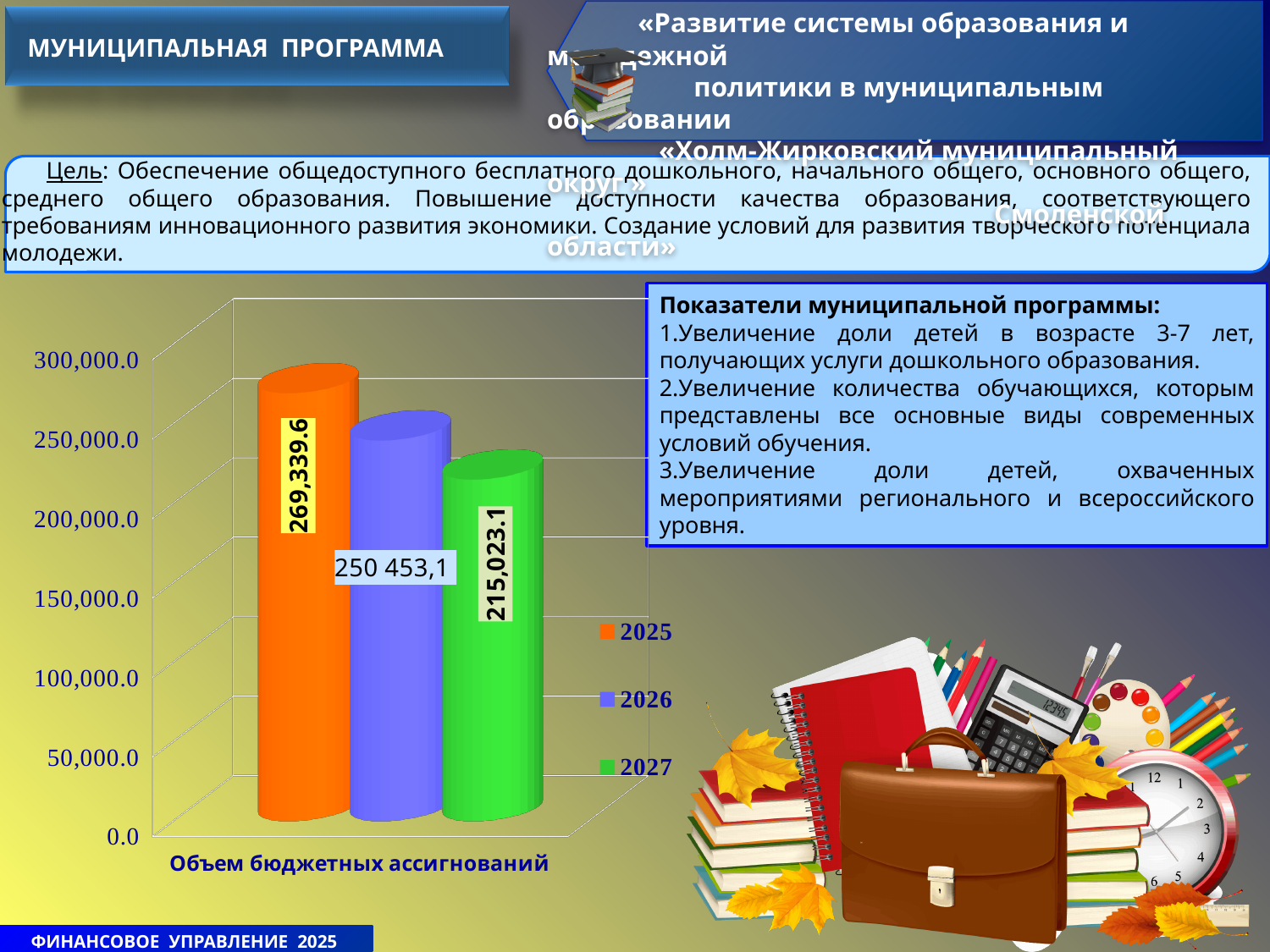
What is the value for 2026 in the chart? 250 453,1 Which year has the lowest value in the chart? 2027 What is the difference between the values for 2026 and 2027? 35,430.0 What is the value for 2027 in the chart? 215,023.1 Which year has the highest value in the chart? 2025 How many series does the legend list? 3 Do the values rise or fall from 2025 to 2027? fall Which is larger, the value for 2025 or the value for 2026? 2025 What is the difference between the values for 2025 and 2027? 54,316.5 What kind of chart is shown on the slide? bar chart What is the value for 2025 in the chart? 269,339.6 Is the value for 2027 greater or less than 200,000.0? greater